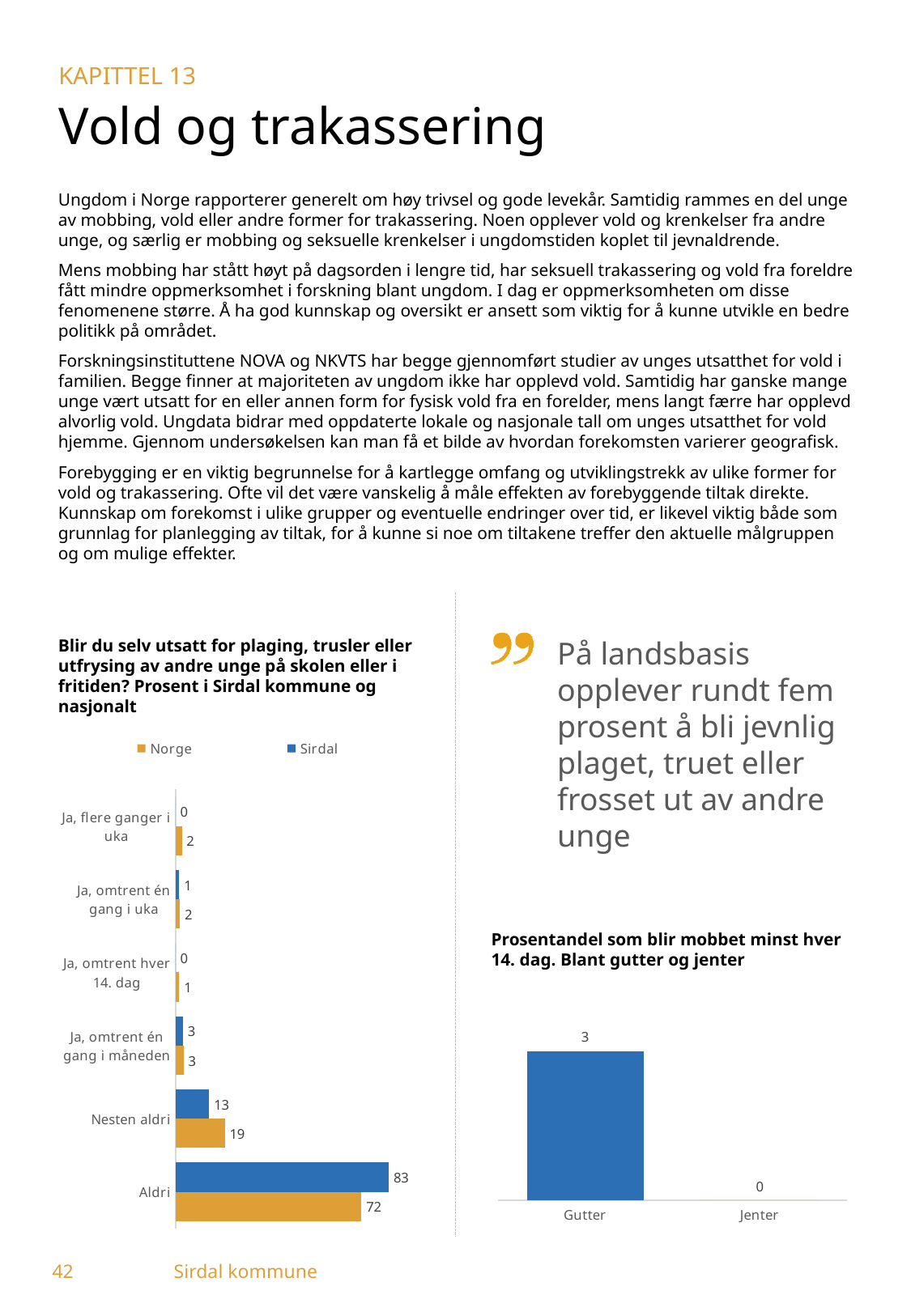
In the chart 'Blir du selv utsatt for plaging, trusler eller utfrysing av andre unge på skolen eller i fritiden?', how many series does the legend list? 2 In the chart 'Blir du selv utsatt for plaging, trusler eller utfrysing av andre unge på skolen eller i fritiden?', what is the difference between Sirdal and Norge in the category 'Aldri'? 11 In the chart 'Blir du selv utsatt for plaging, trusler eller utfrysing av andre unge på skolen eller i fritiden?', which is larger in the category 'Nesten aldri', Norge or Sirdal? Norge In the chart 'Prosentandel som blir mobbet minst hver 14. dag. Blant gutter og jenter', what is the value for Jenter? 0 In the chart 'Blir du selv utsatt for plaging, trusler eller utfrysing av andre unge på skolen eller i fritiden?', what is the value for Sirdal in the category 'Ja, omtrent én gang i uka'? 1 In the chart 'Blir du selv utsatt for plaging, trusler eller utfrysing av andre unge på skolen eller i fritiden?', which colour represents Norge in the legend? Orange In the chart 'Blir du selv utsatt for plaging, trusler eller utfrysing av andre unge på skolen eller i fritiden?', what is the value for Sirdal in the category 'Aldri'? 83 In the chart 'Blir du selv utsatt for plaging, trusler eller utfrysing av andre unge på skolen eller i fritiden?', which category has the highest value for Norge? Aldri What kind of chart is 'Blir du selv utsatt for plaging, trusler eller utfrysing av andre unge på skolen eller i fritiden?'? Bar chart In the chart 'Blir du selv utsatt for plaging, trusler eller utfrysing av andre unge på skolen eller i fritiden?', how many categories are shown? 6 In the chart 'Prosentandel som blir mobbet minst hver 14. dag. Blant gutter og jenter', what is the value for Gutter? 3 In the chart 'Blir du selv utsatt for plaging, trusler eller utfrysing av andre unge på skolen eller i fritiden?', what is the value for Norge in the category 'Nesten aldri'? 19